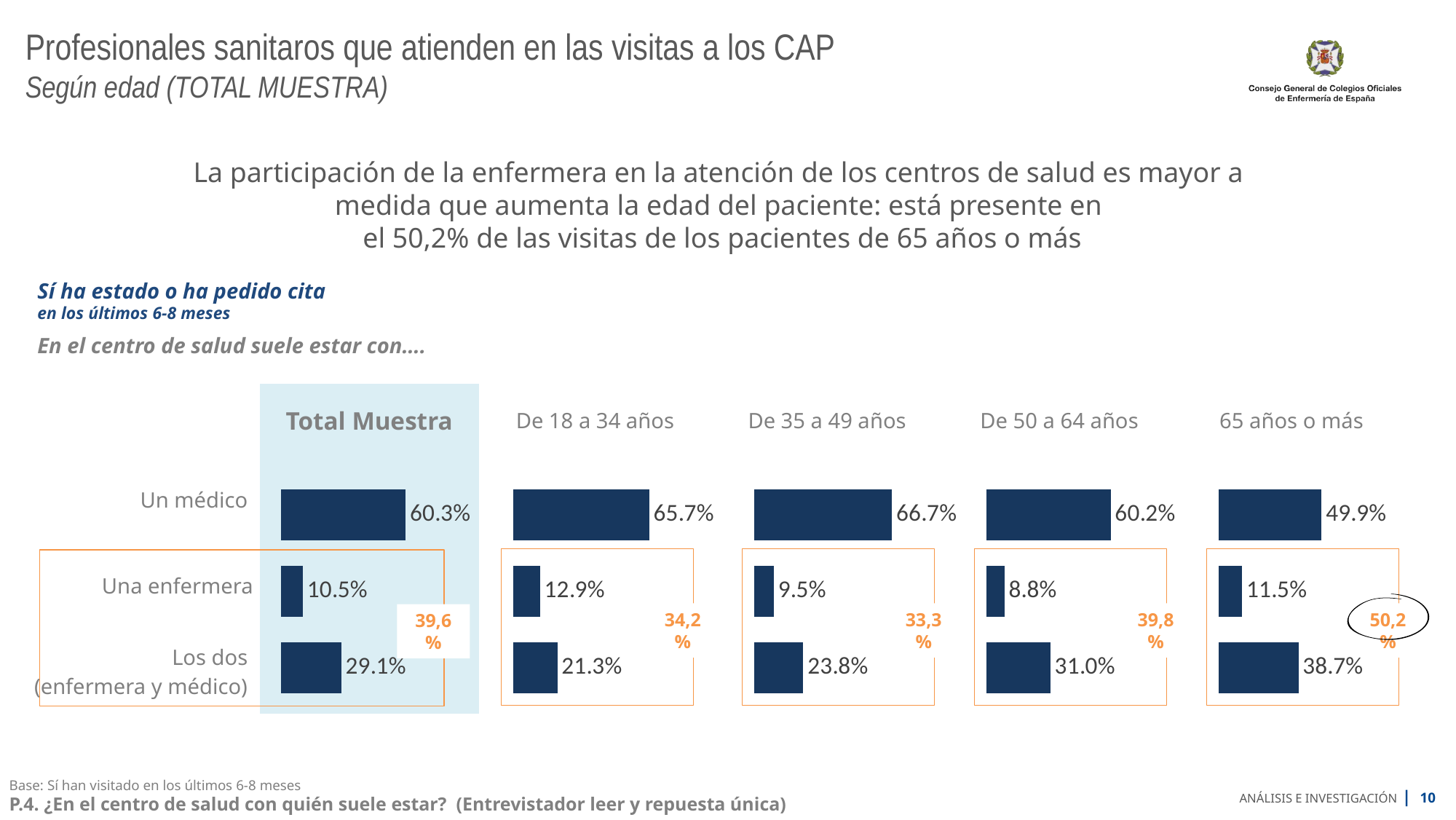
In the '65 años o más' chart, which is larger: 'Un médico' or 'Los dos (enfermera y médico)'? Un médico In the 'De 35 a 49 años' chart, which category has the highest value? Un médico In the 'De 50 a 64 años' chart, what is the combined value shown in orange for 'Una enfermera' and 'Los dos'? 39,8% In the 'Total Muestra' chart, what is the value for 'Un médico'? 60.3% Across the four age-group charts, which age group has the highest value for 'Un médico'? De 35 a 49 años How many separate charts are shown on the slide? 5 In the '65 años o más' chart, what is the value for 'Los dos (enfermera y médico)'? 38.7% In the 'De 18 a 34 años' chart, what is the value for 'Una enfermera'? 12.9% In the 'Total Muestra' chart, what is the difference between 'Un médico' and 'Los dos (enfermera y médico)'? 31.2% In the 'De 50 a 64 años' chart, which category has the lowest value? Una enfermera How many categories does each chart on the slide show? 3 What kind of chart is used for the 'De 18 a 34 años' data? Bar chart